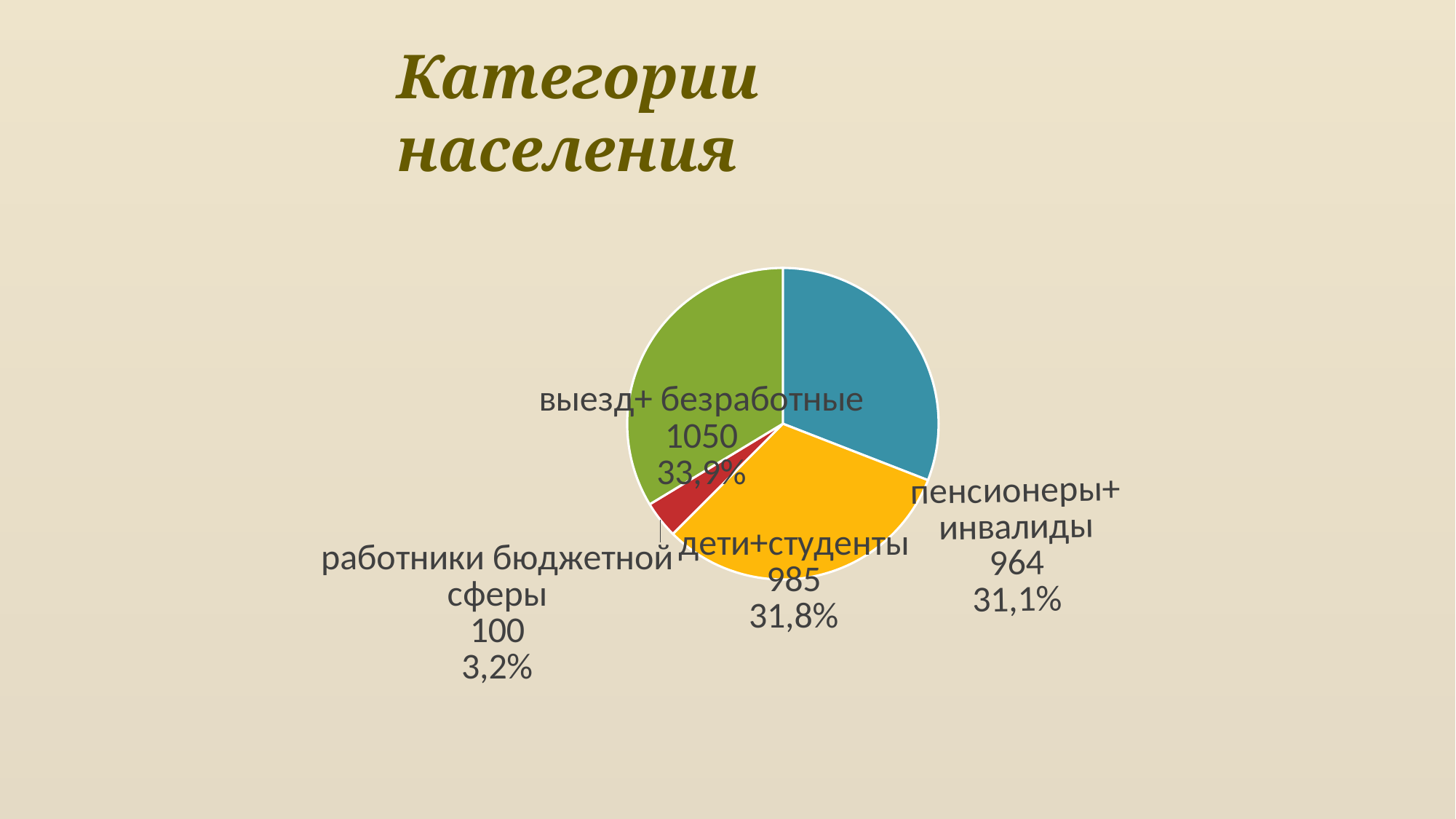
What is the difference between the values for "выезд+ безработные" and "дети+студенты"? 65 What share of the pie does "работники бюджетной сферы" represent? 3,2% What is the value for "работники бюджетной сферы"? 100 Which is larger, the value for "дети+студенты" or the value for "пенсионеры+ инвалиды"? дети+студенты What share of the pie does "дети+студенты" represent? 31,8% What is the value for "пенсионеры+ инвалиды"? 964 What is the value for "выезд+ безработные"? 1050 What kind of chart is shown on the slide? pie chart Which category has the largest slice? выезд+ безработные Which category has the smallest slice? работники бюджетной сферы What is the title of the chart? Категории населения How many categories does the pie chart show? 4